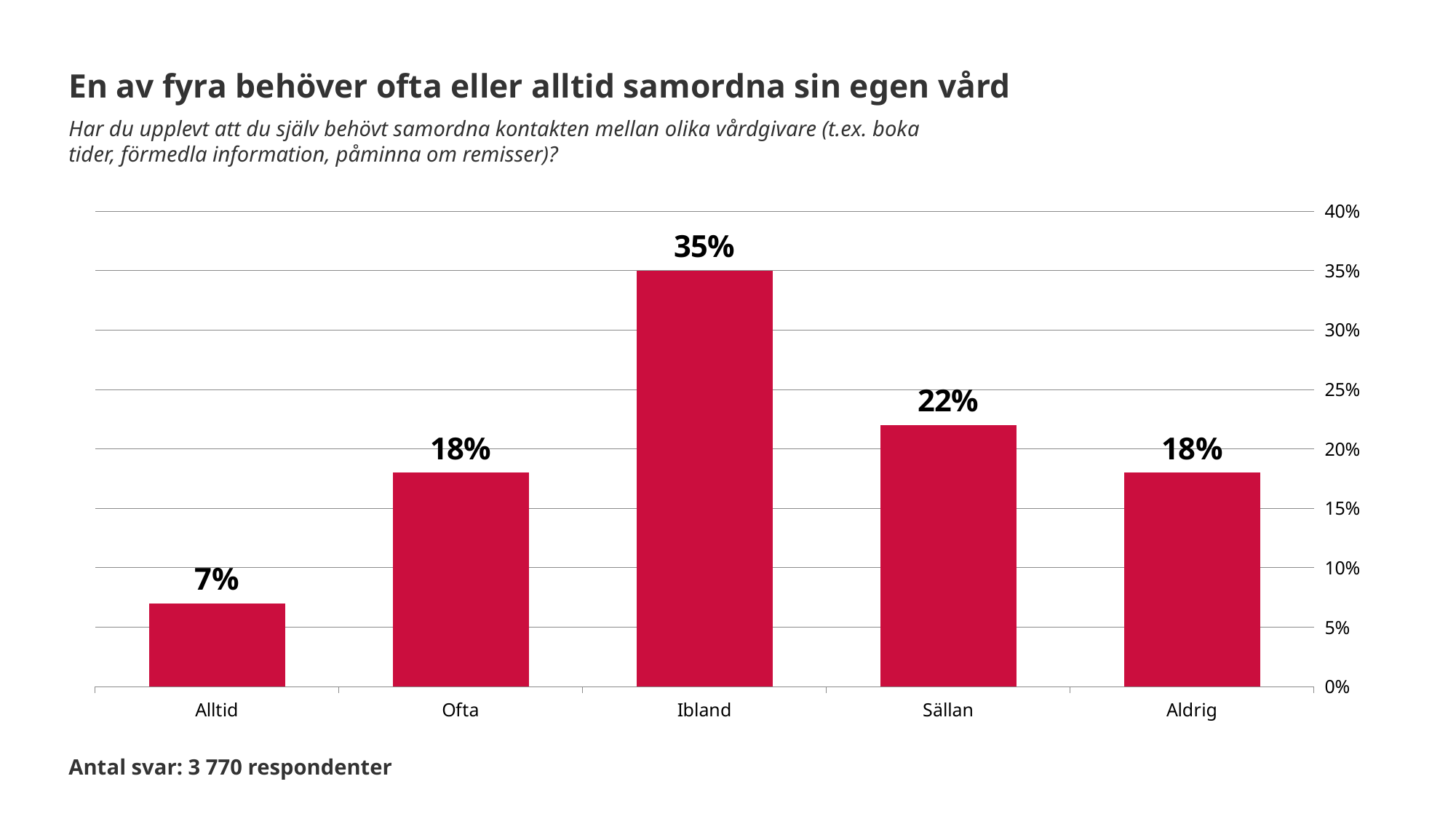
What is the value for Ibland? 35% Which category has the lowest value? Alltid Which category has the highest value? Ibland How many categories are shown on the x axis? 5 What is the difference between the values for Ofta and Alltid? 11% What is the value for Sällan? 22% What is the value for Alltid? 7% Which is larger, the value for Sällan or the value for Aldrig? Sällan How many respondents does the note below the chart state? 3 770 respondenter What is the difference between the values for Ibland and Sällan? 13% What kind of chart is shown on the slide? Bar chart Is the value for Ibland greater or less than 30%? greater